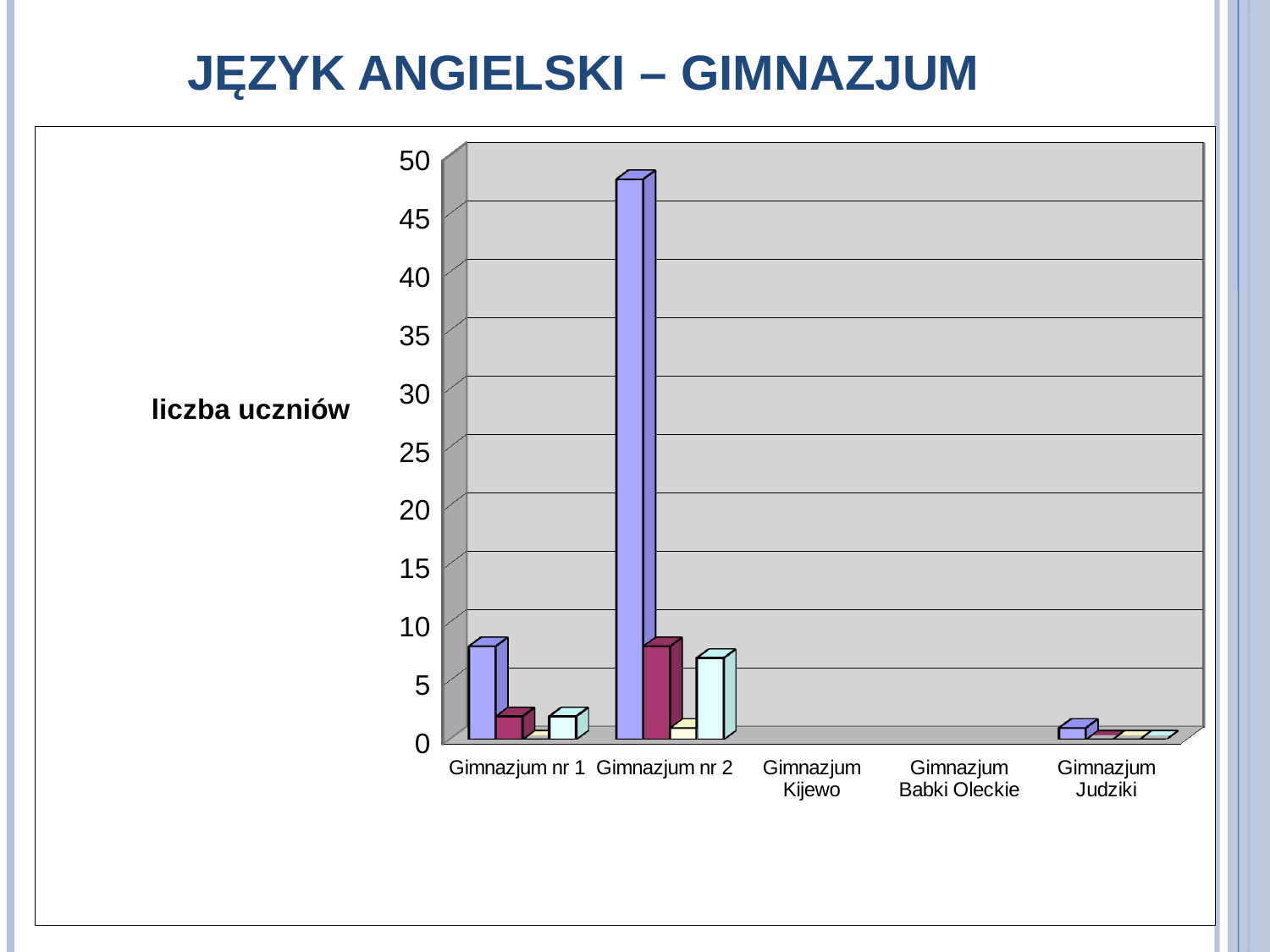
Is the tallest bar for Gimnazjum nr 2 greater or less than 40? greater Which category has the tallest bar in the chart? Gimnazjum nr 2 Which has a taller tallest bar, Gimnazjum nr 1 or Gimnazjum Judziki? Gimnazjum nr 1 Is the tallest bar for Gimnazjum nr 1 greater or less than 10? less What kind of chart is shown on the slide? bar chart How many categories show no visible bars at all? 2 What is the highest value shown on the vertical axis? 50 Which has a taller tallest bar, Gimnazjum nr 1 or Gimnazjum nr 2? Gimnazjum nr 2 What label is shown next to the vertical axis of the chart? liczba uczniów Is the tallest bar for Gimnazjum Judziki greater or less than 5? less What is the title of the slide above the chart? JĘZYK ANGIELSKI – GIMNAZJUM How many categories are shown on the x axis of the chart? 5